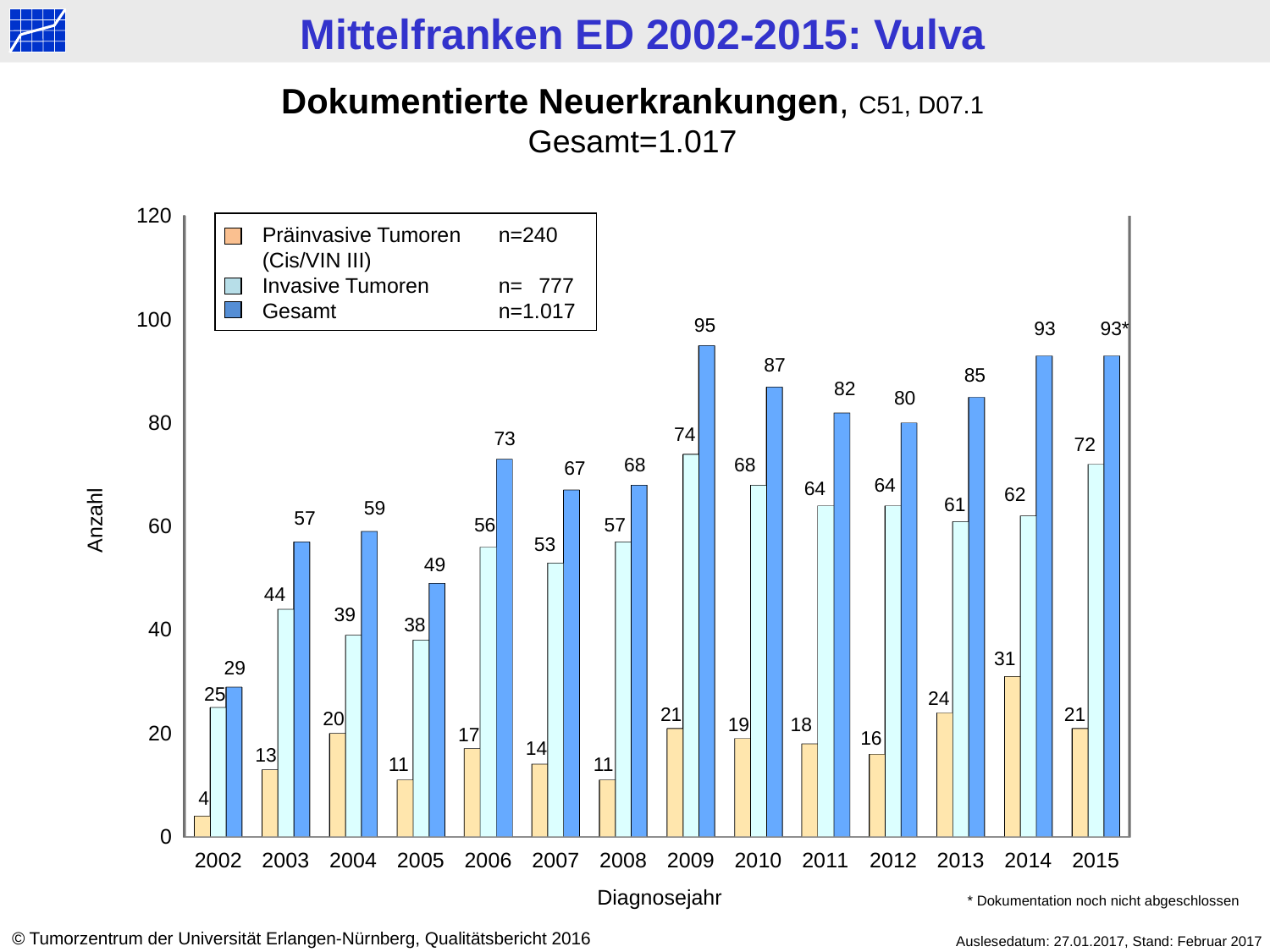
What is the value for Invasive Tumoren in 2015? 72 What is the Gesamt value for 2009? 95 How many diagnosis years are shown on the x axis? 14 How many series does the legend list? 3 Which is larger: the Invasive Tumoren value in 2006 or in 2007? 2006 In which year is the Präinvasive Tumoren (Cis/VIN III) value lowest? 2002 In which year is the Gesamt value highest? 2009 What type of chart is shown on the slide? bar chart What is the n value given for Invasive Tumoren in the legend? 777 In which year is the Präinvasive Tumoren (Cis/VIN III) value highest? 2014 What is the value for Präinvasive Tumoren (Cis/VIN III) in 2004? 20 What is the difference between the Gesamt values for 2009 and 2002? 66